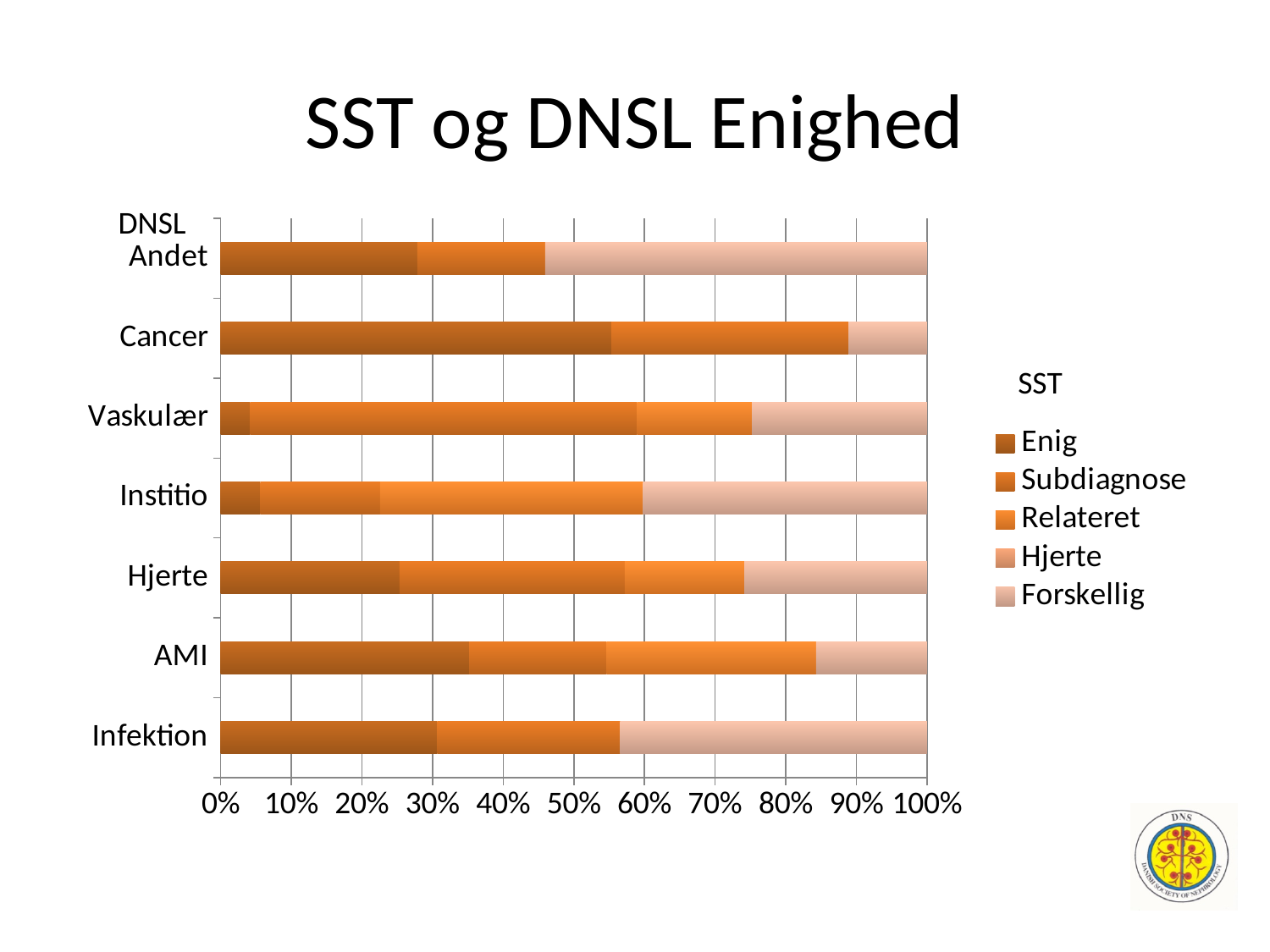
What is the heading shown above the legend entries? SST Is the Enig value for Hjerte greater or less than 30%? less Which has the larger Enig segment, Cancer or AMI? Cancer Is the Enig value for Cancer greater or less than 50%? greater Is the Enig value for AMI greater or less than 30%? greater What kind of chart is shown on the slide? bar chart Which category has the largest Enig segment? Cancer What is the title of the chart? SST og DNSL Enighed How many categories are shown on the vertical axis of the chart? 7 How many series does the legend list? 5